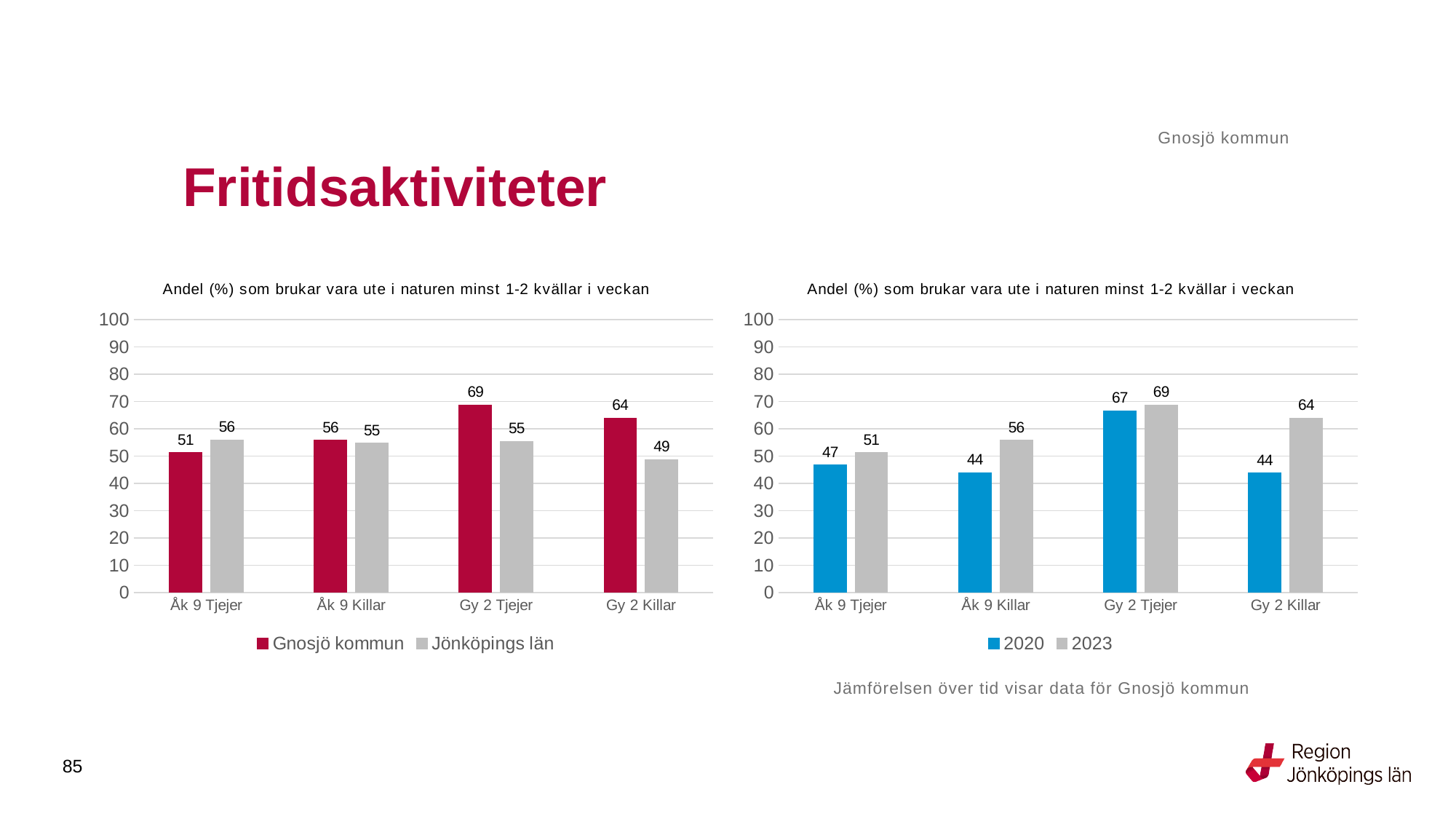
In the left chart, what is the value for Jönköpings län for Gy 2 Killar? 49 In the left chart, what is the difference between Gnosjö kommun and Jönköpings län for Gy 2 Killar? 15 In the right chart, what is the value for 2023 for Gy 2 Killar? 64 In the left chart, which category has the highest value for Gnosjö kommun? Gy 2 Tjejer How many series does the legend of the right chart list? 2 In the right chart, what is the value for 2020 for Åk 9 Killar? 44 How many categories are shown on the x axis of the left chart? 4 In the right chart, what is the difference between 2023 and 2020 for Gy 2 Killar? 20 In the right chart, which is larger for Åk 9 Tjejer: 2020 or 2023? 2023 In the left chart, what is the value for Gnosjö kommun for Gy 2 Tjejer? 69 In the right chart, which category has the lowest value for 2023? Åk 9 Tjejer What kind of chart is the left chart? Bar chart